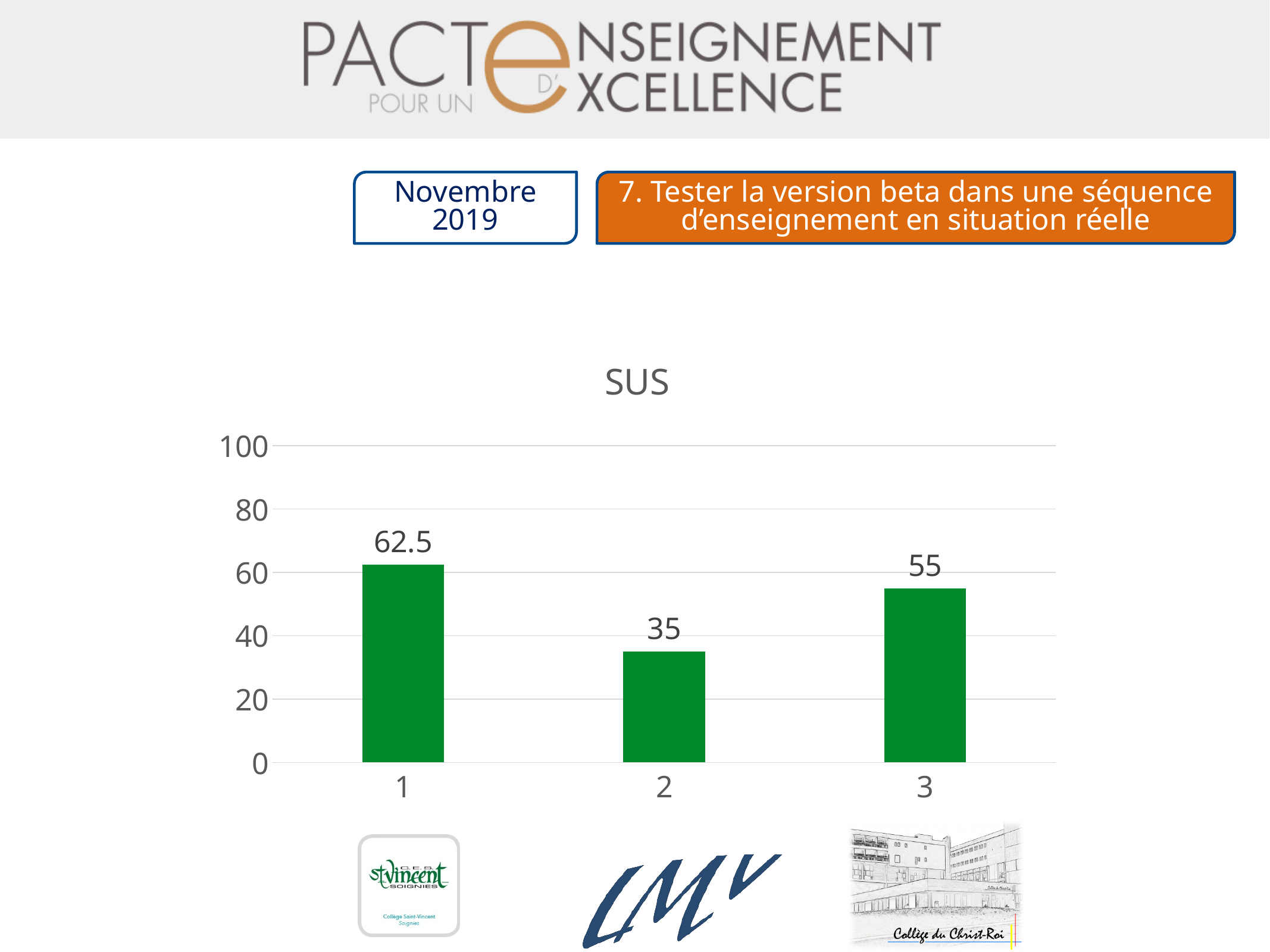
How many categories are shown in the SUS chart? 3 What is the difference between the values for category 1 and category 2? 27.5 Which category has the highest value in the SUS chart? 1 Is the value for category 2 greater or less than 40? less What is the difference between the values for category 3 and category 2? 20 What is the value for category 3 in the SUS chart? 55 What is the value for category 1 in the SUS chart? 62.5 What is the title of the chart? SUS What kind of chart is shown on the slide? bar chart What is the value for category 2 in the SUS chart? 35 Which category has the lowest value in the SUS chart? 2 Which is larger, the value for category 1 or the value for category 3? 1